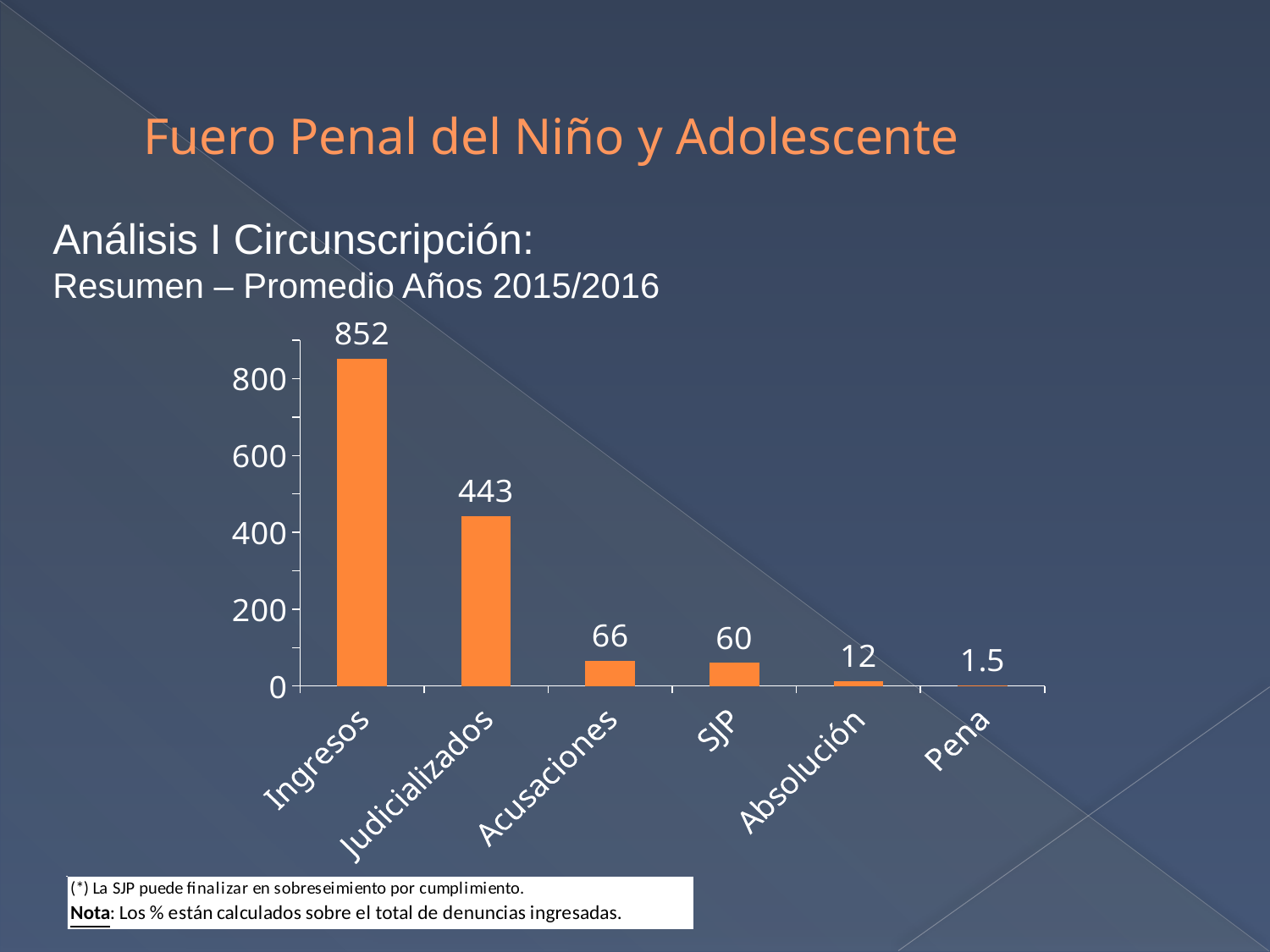
Do the values rise or fall from left to right along the x axis? Fall What is the value for Judicializados? 443 What is the difference between the values for Ingresos and Judicializados? 409 Which is larger, the value for SJP or the value for Absolución? SJP Which category has the highest value? Ingresos Which category has the lowest value? Pena What is the value for Ingresos? 852 What kind of chart is shown on the slide? Bar chart What is the difference between the values for Acusaciones and SJP? 6 What is the value for Pena? 1.5 What is the value for Acusaciones? 66 How many categories are shown on the x axis? 6